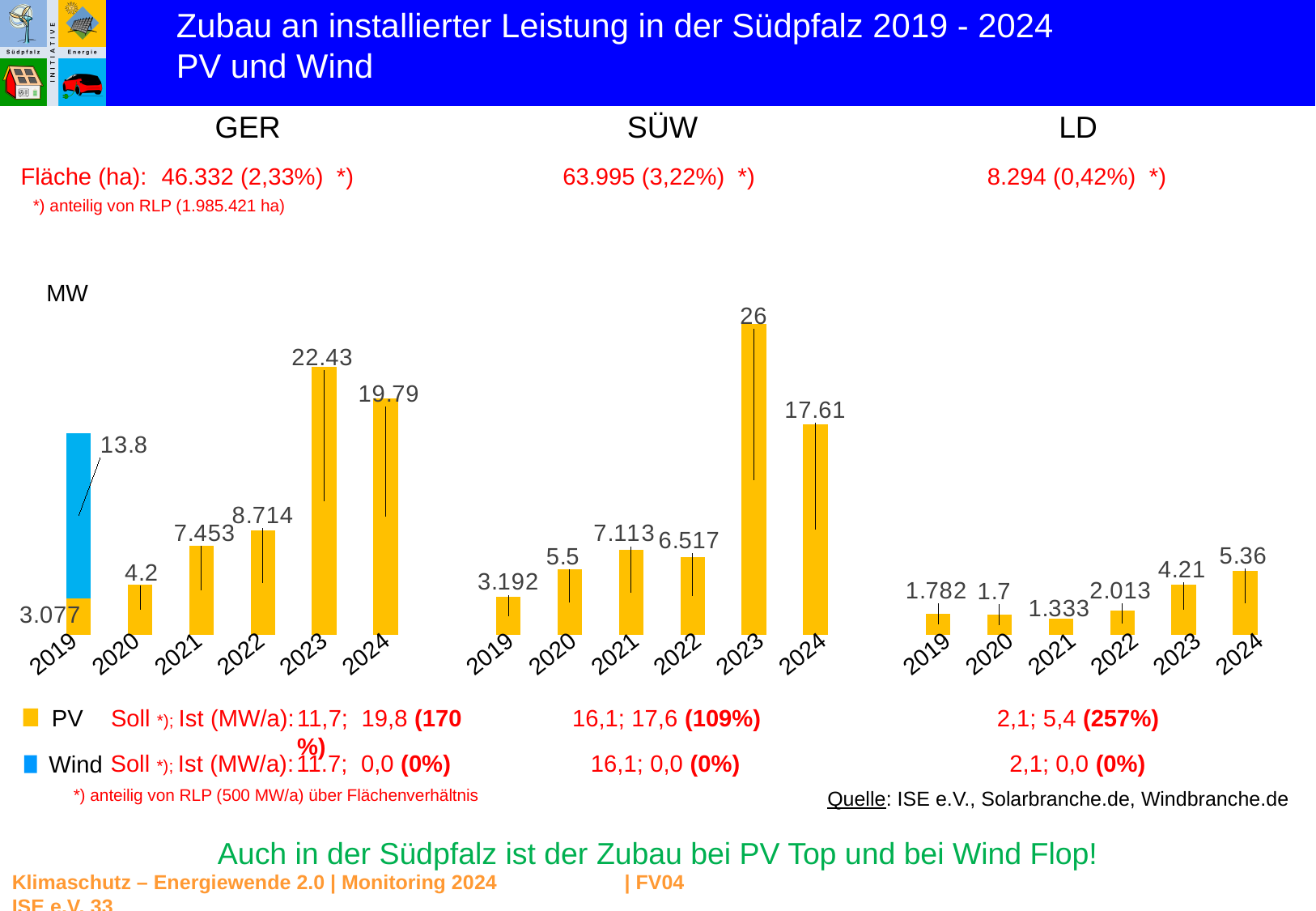
In the GER chart, what is the Wind value for 2019? 13.8 In the SÜW chart, what is the value for 2023? 26 How many years are shown on the x axis of the LD chart? 6 In the GER chart, what is the PV value for 2023? 22.43 What kind of chart is the SÜW chart? bar chart In the SÜW chart, which is larger, the value for 2021 or the value for 2022? 2021 In the SÜW chart, which year has the highest value? 2023 In the LD chart, what is the value for 2024? 5.36 In the GER chart, what is the difference between the PV values for 2023 and 2024? 2.64 In the LD chart, which year has the lowest value? 2021 How many series does the legend list? 2 Which colour represents Wind in the legend? blue